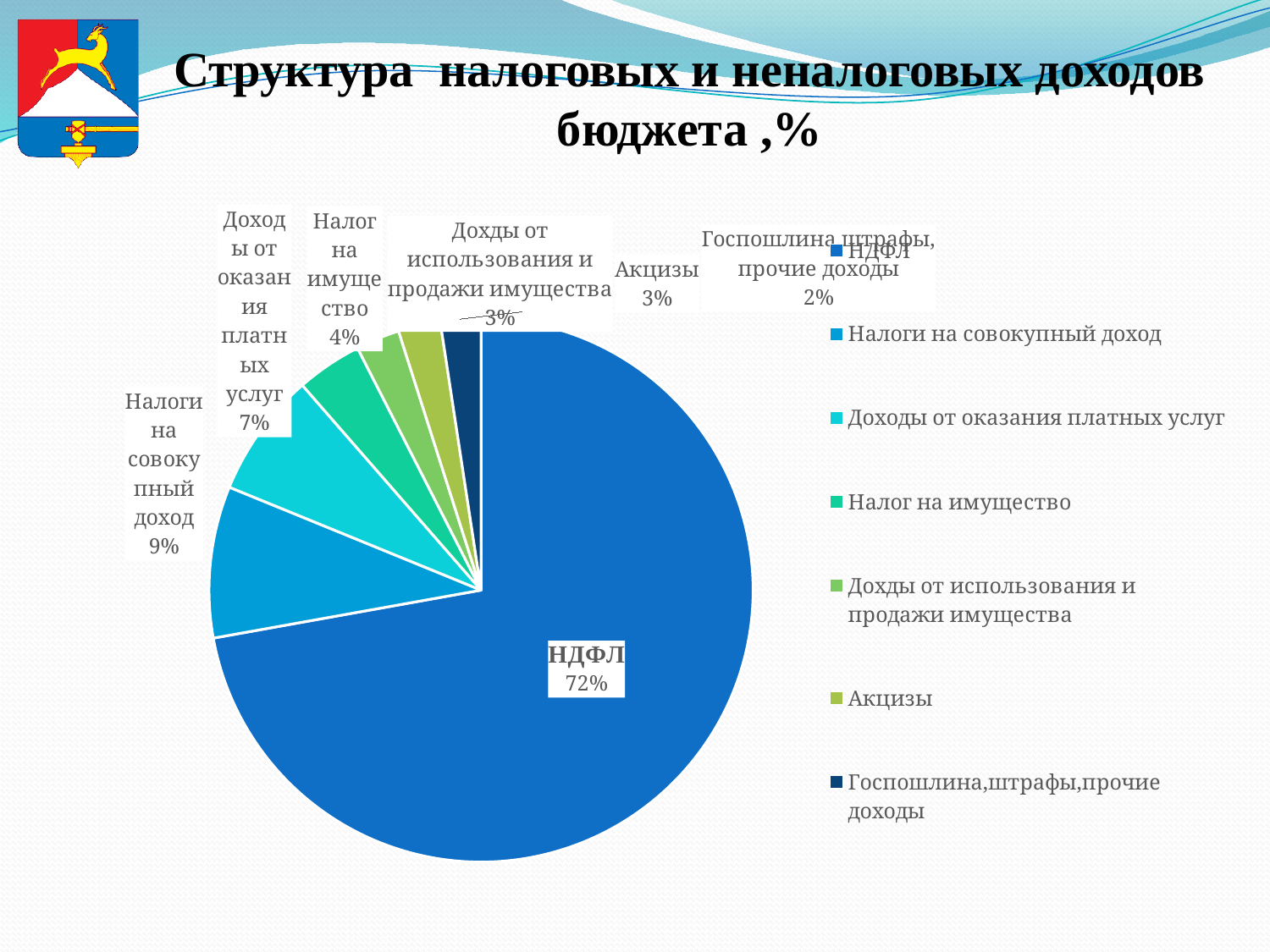
Which is larger: the share of Доходы от оказания платных услуг or the share of Налог на имущество? Доходы от оказания платных услуг What is the value shown for Доходы от оказания платных услуг? 7% What is the value shown for Госпошлина, штрафы, прочие доходы? 2% What kind of chart is shown on the slide? pie chart How many slices does the pie chart have? 7 What is the value shown for Налог на имущество? 4% What is the title of the slide's chart? Структура налоговых и неналоговых доходов бюджета ,% Which category has the largest slice of the pie? НДФЛ What share of the pie does НДФЛ have? 72% What is the difference between the share of НДФЛ and the share of Налоги на совокупный доход? 63% What is the value shown for Налоги на совокупный доход? 9% Which category has the smallest slice of the pie? Госпошлина,штрафы,прочие доходы